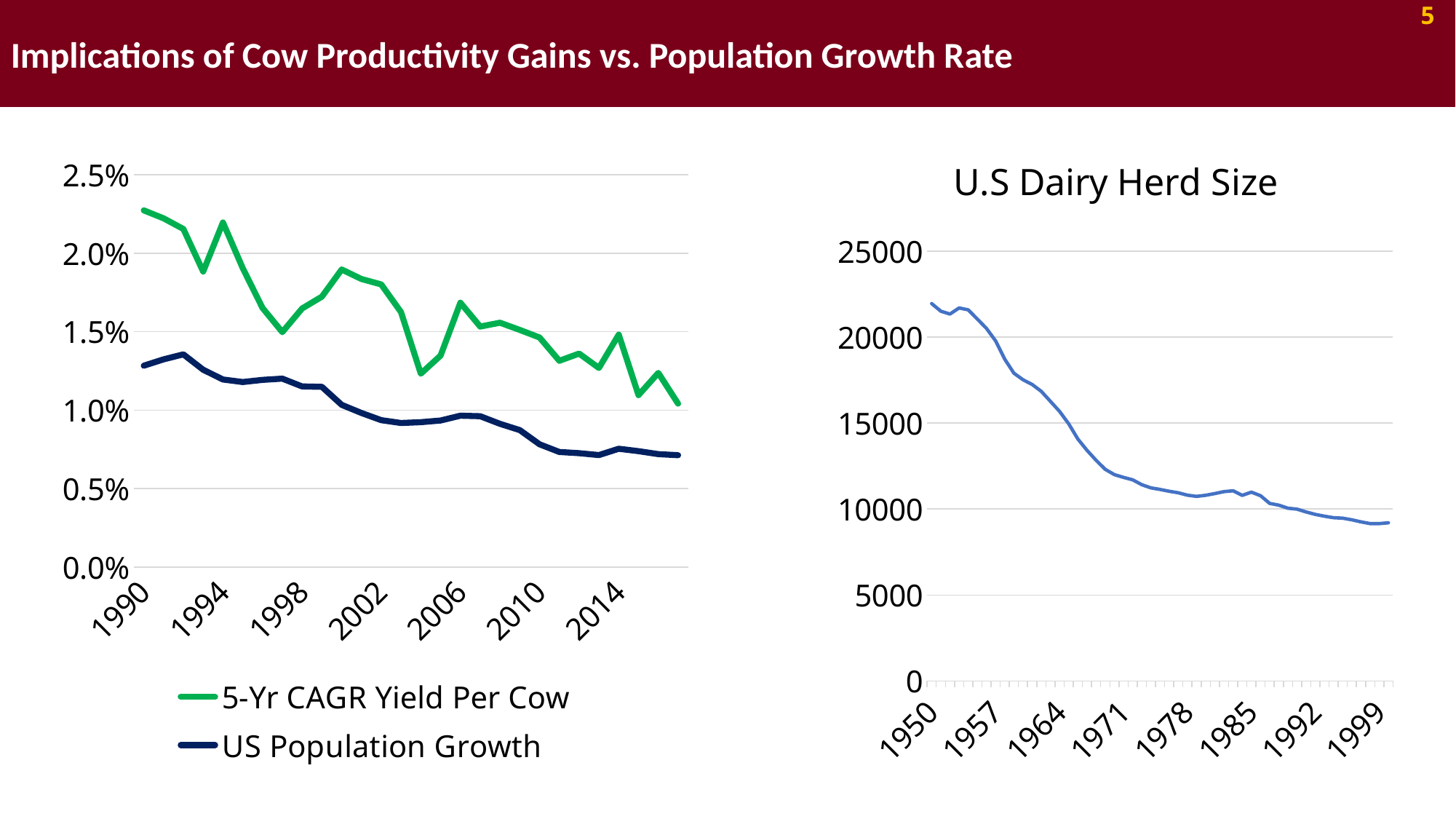
In the 'U.S Dairy Herd Size' chart, is the value for 1950 greater or less than 20000? greater In the chart on the left, how many series does the legend list? 2 What kind of chart is the 'U.S Dairy Herd Size' chart? line chart What kind of chart is the chart on the left of the slide? line chart In the chart on the left, which series is drawn in green? 5-Yr CAGR Yield Per Cow In the chart on the left, which series has the higher value in 1990, 5-Yr CAGR Yield Per Cow or US Population Growth? 5-Yr CAGR Yield Per Cow In the chart on the left, what are the two series named in the legend? 5-Yr CAGR Yield Per Cow and US Population Growth In the chart on the left, does the US Population Growth line generally rise or fall from 1990 to the end of the series? fall In the chart on the left, is the value for US Population Growth in 2014 greater or less than 1.0%? less In the 'U.S Dairy Herd Size' chart, does the herd size rise or fall from 1950 to 1999? fall In the chart on the left, is the value for US Population Growth in 1990 greater or less than 1.0%? greater